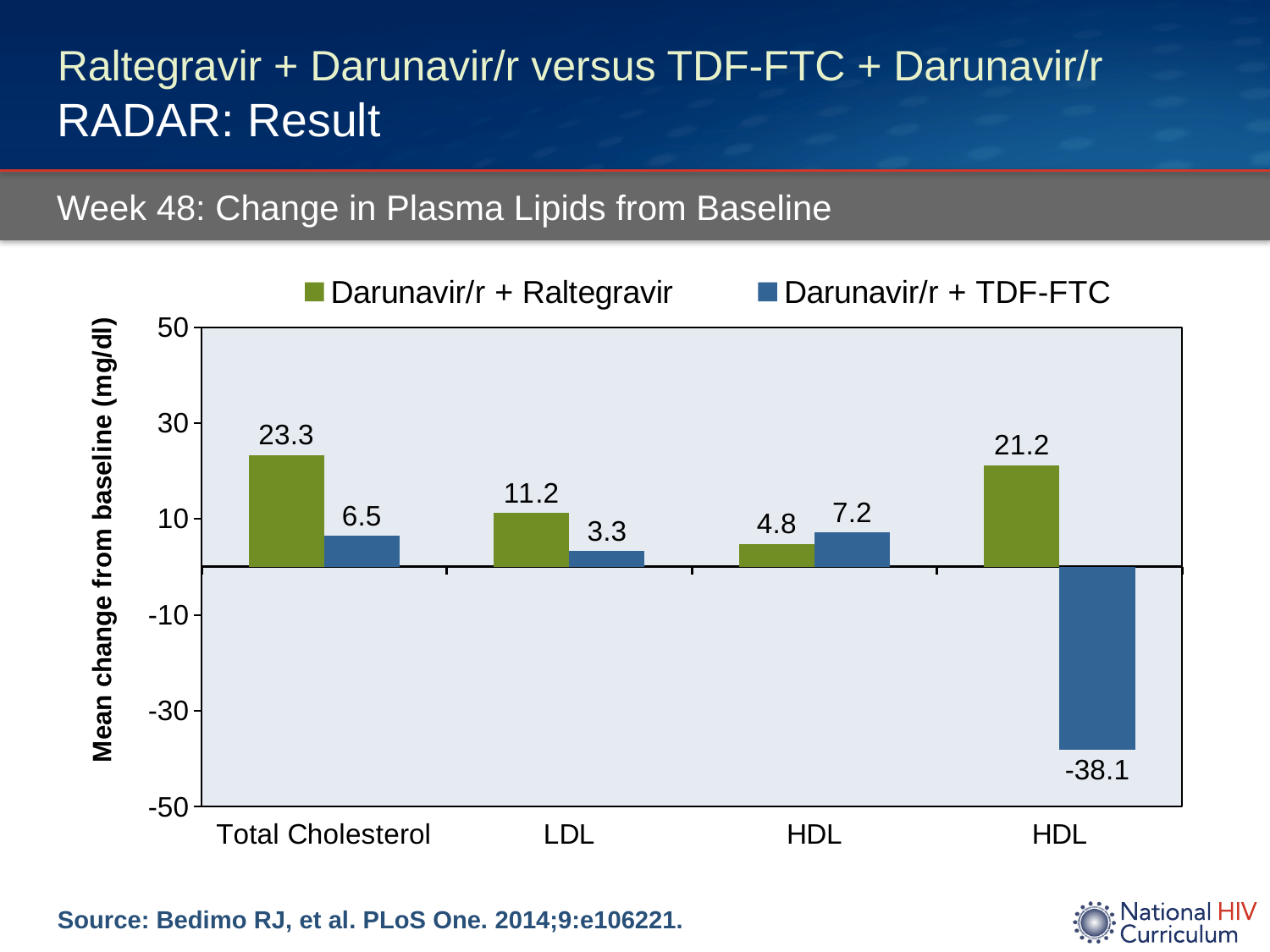
In which category does Darunavir/r + Raltegravir have its highest value? Total Cholesterol How many series does the legend list? 2 What is the difference between the Darunavir/r + Raltegravir and Darunavir/r + TDF-FTC values for Total Cholesterol? 16.8 What is the mean change from baseline in Total Cholesterol for Darunavir/r + Raltegravir? 23.3 What is the mean change from baseline in LDL for Darunavir/r + TDF-FTC? 3.3 What is the value for Darunavir/r + Raltegravir in the rightmost category of the chart? 21.2 What is the lowest value shown on the chart? -38.1 How many categories are shown on the x axis of the chart? 4 What type of chart is shown on the slide? Bar chart What is the difference between the Darunavir/r + Raltegravir and Darunavir/r + TDF-FTC values for LDL? 7.9 For LDL, which series has the larger value: Darunavir/r + Raltegravir or Darunavir/r + TDF-FTC? Darunavir/r + Raltegravir What is the value for Darunavir/r + TDF-FTC in the rightmost category of the chart? -38.1